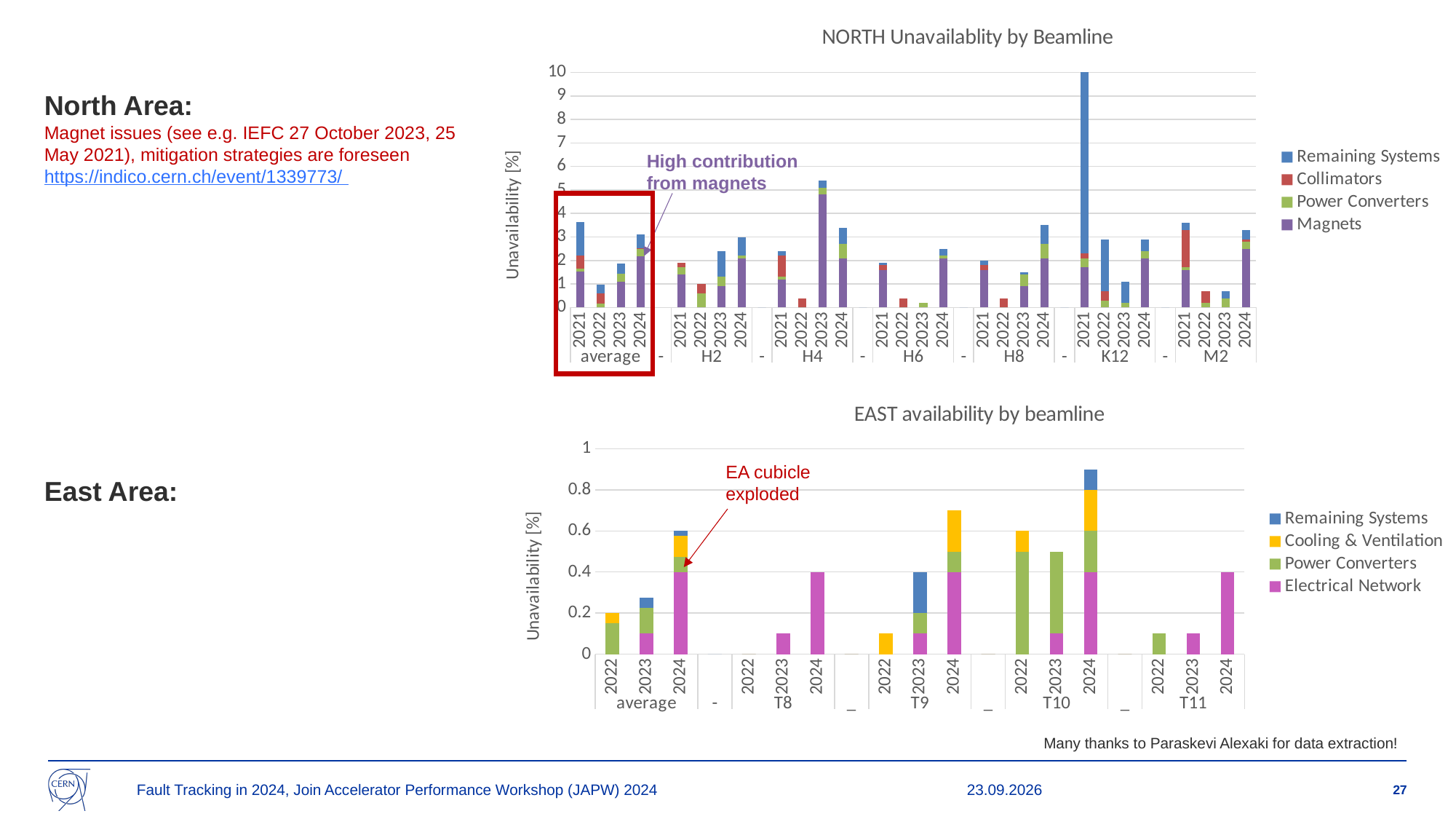
Which series is shown in yellow in the EAST availability by beamline chart? Cooling & Ventilation What kind of chart is the NORTH Unavailablity by Beamline chart? Stacked bar chart In the NORTH Unavailablity by Beamline chart, is the total value for K12 in 2021 greater or less than 5? greater In the EAST availability by beamline chart, is the total value for T10 in 2024 greater or less than 0.8? greater In the NORTH Unavailablity by Beamline chart, is the total value for M2 in 2023 greater or less than 1? less How many beamline groups (including average) are shown on the x axis of the NORTH Unavailablity by Beamline chart? 7 How many series does the legend of the NORTH Unavailablity by Beamline chart list? 4 In the EAST availability by beamline chart, which beamline and year has the highest total bar? T10 2024 In the NORTH Unavailablity by Beamline chart, which beamline and year has the highest total unavailability? K12 2021 In the EAST availability by beamline chart, which is larger: the total for T9 in 2024 or the total for T10 in 2024? T10 in 2024 How many series does the legend of the EAST availability by beamline chart list? 4